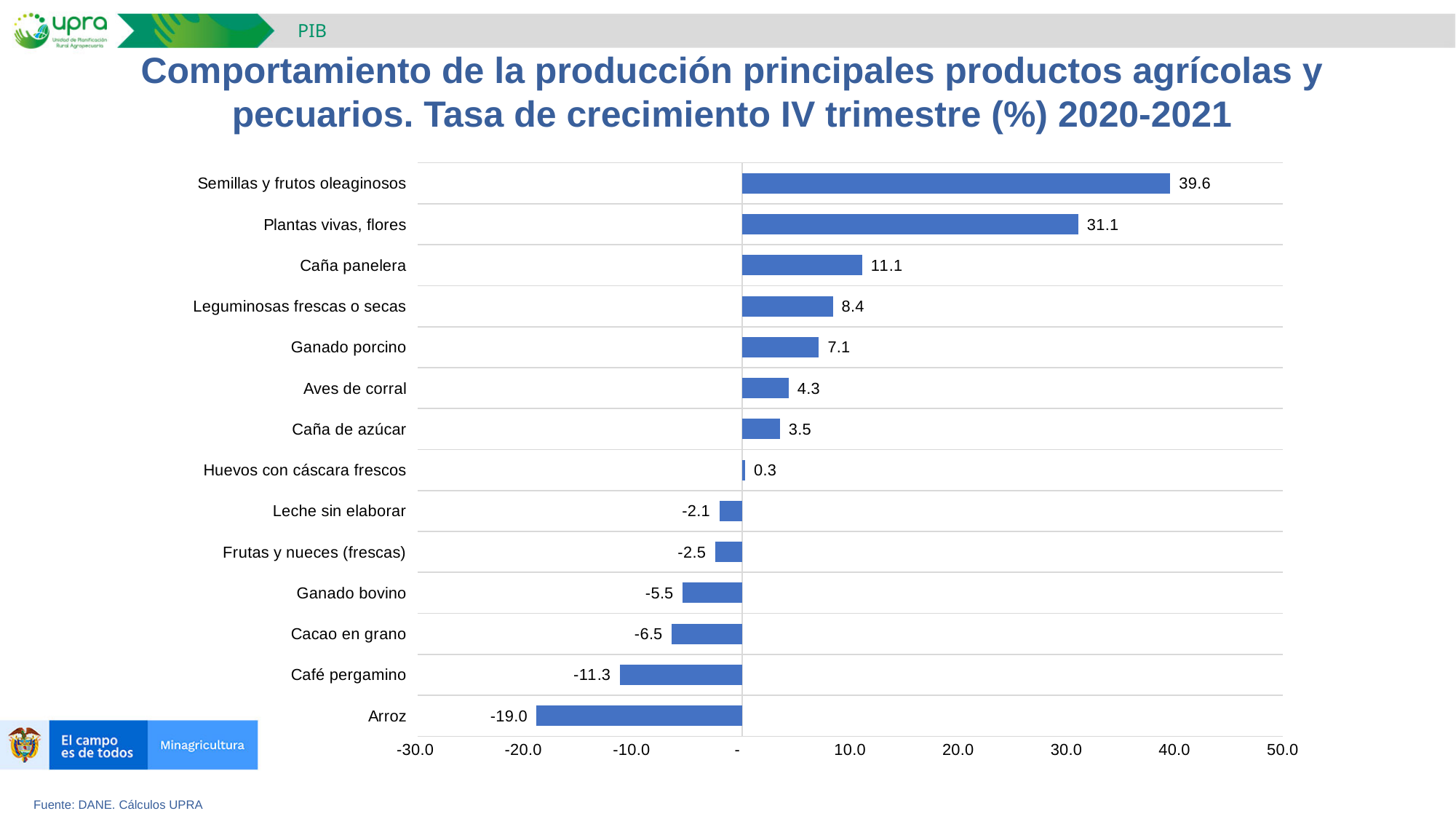
Which has a higher value, Ganado porcino or Aves de corral? Ganado porcino How many categories are shown in the chart? 14 What kind of chart is shown on the slide? Bar chart Which category has the highest growth rate? Semillas y frutos oleaginosos What is the value shown for Huevos con cáscara frescos? 0.3 What source is cited for the chart data? DANE. Cálculos UPRA What is the growth rate shown for Semillas y frutos oleaginosos? 39.6 Which has a lower value, Cacao en grano or Ganado bovino? Cacao en grano Which category has the lowest growth rate? Arroz What is the value shown for Café pergamino? -11.3 What is the difference between the values for Semillas y frutos oleaginosos and Plantas vivas, flores? 8.5 What is the difference between the values for Caña panelera and Leguminosas frescas o secas? 2.7